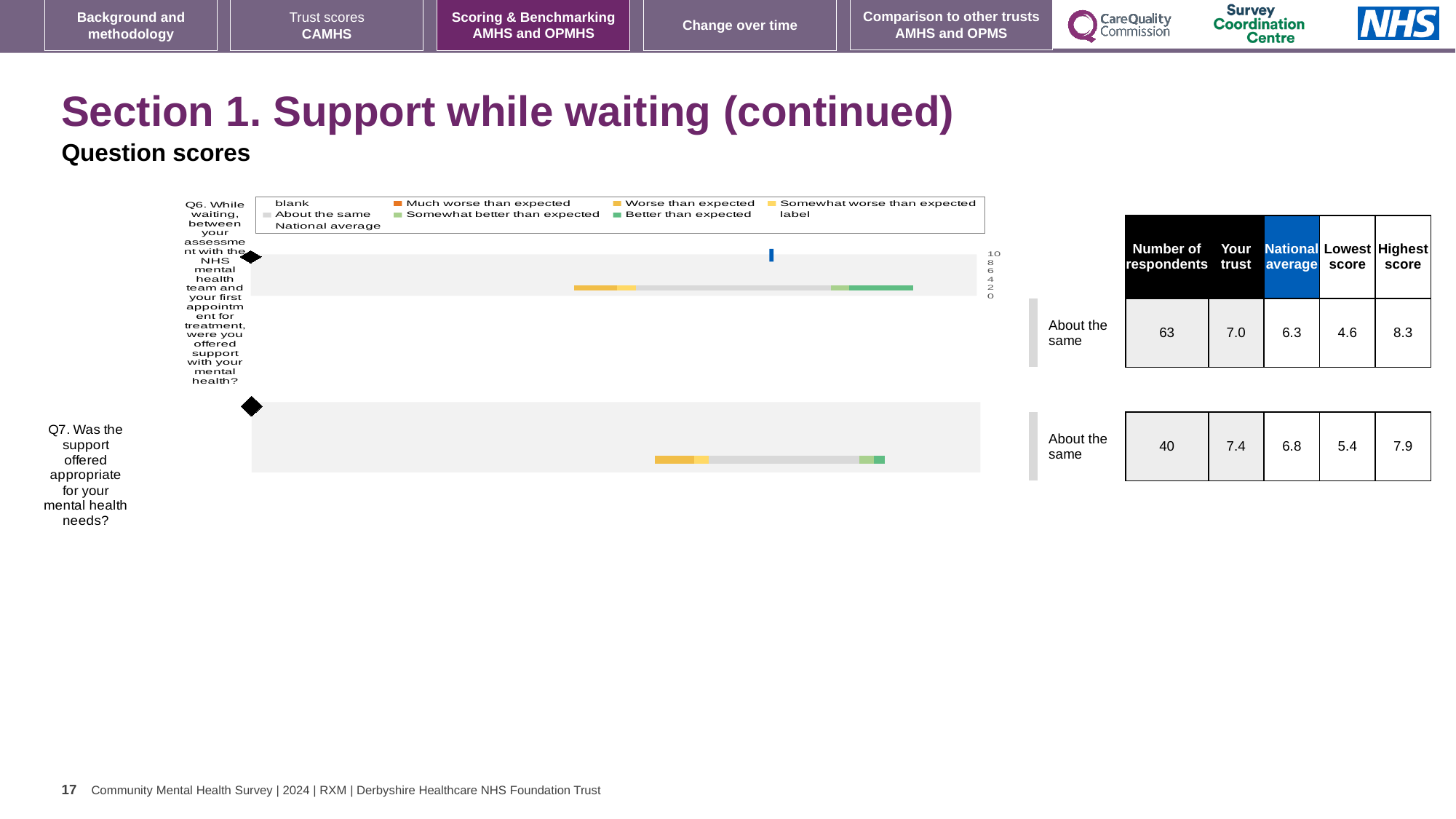
For Q6, what is the national average score shown next to the chart? 6.3 What is the highest score among trusts for Q7? 7.9 For Q7, what is the national average score? 6.8 For Q6, what is the difference between the trust's score and the national average? 0.7 How many respondents answered Q7? 40 For Q6 (support while waiting between assessment and first appointment), what is the trust's score shown in the table next to the chart? 7.0 How many survey questions are charted on this slide? 2 For Q7 (was the support offered appropriate for your mental health needs), what is the trust's score? 7.4 For Q6, is the trust's score higher or lower than the national average? higher What benchmark category is the trust's Q7 score placed in? About the same For Q7, what is the difference between the trust's score and the national average? 0.6 How many respondents answered Q6? 63